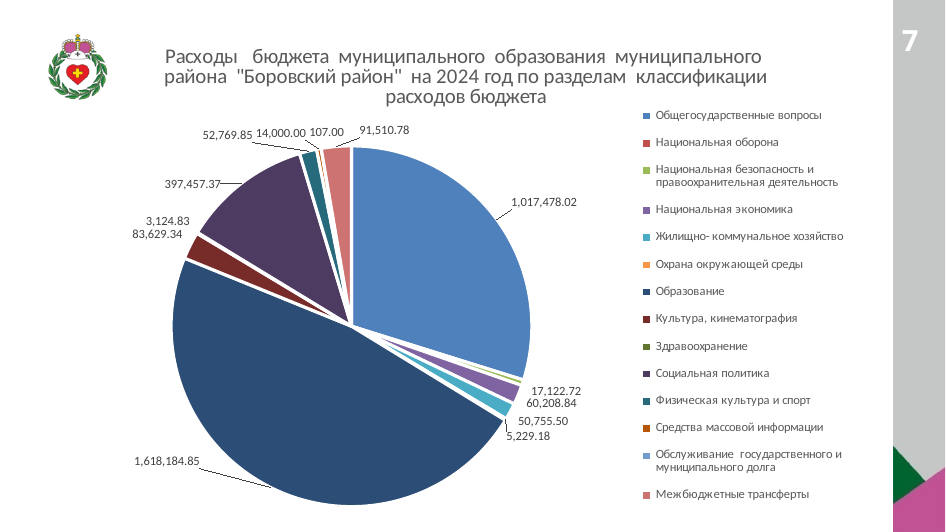
What is the smallest value labelled on the pie chart? 107.00 Which is larger: the value for Образование or the value for Общегосударственные вопросы? Образование What is the value shown for Общегосударственные вопросы? 1,017,478.02 For which year does the chart title say the budget expenditures are shown? 2024 What is the value shown for Образование? 1,618,184.85 Which is larger: the value for Социальная политика or the value for Межбюджетные трансферты? Социальная политика Which category has the largest slice in the pie chart? Образование What type of chart is shown on the slide? Pie chart What is the value shown for Социальная политика? 397,457.37 What is the difference between the values for Образование and Общегосударственные вопросы? 600,706.83 How many categories does the legend of the pie chart list? 14 What is the value shown for Межбюджетные трансферты? 91,510.78